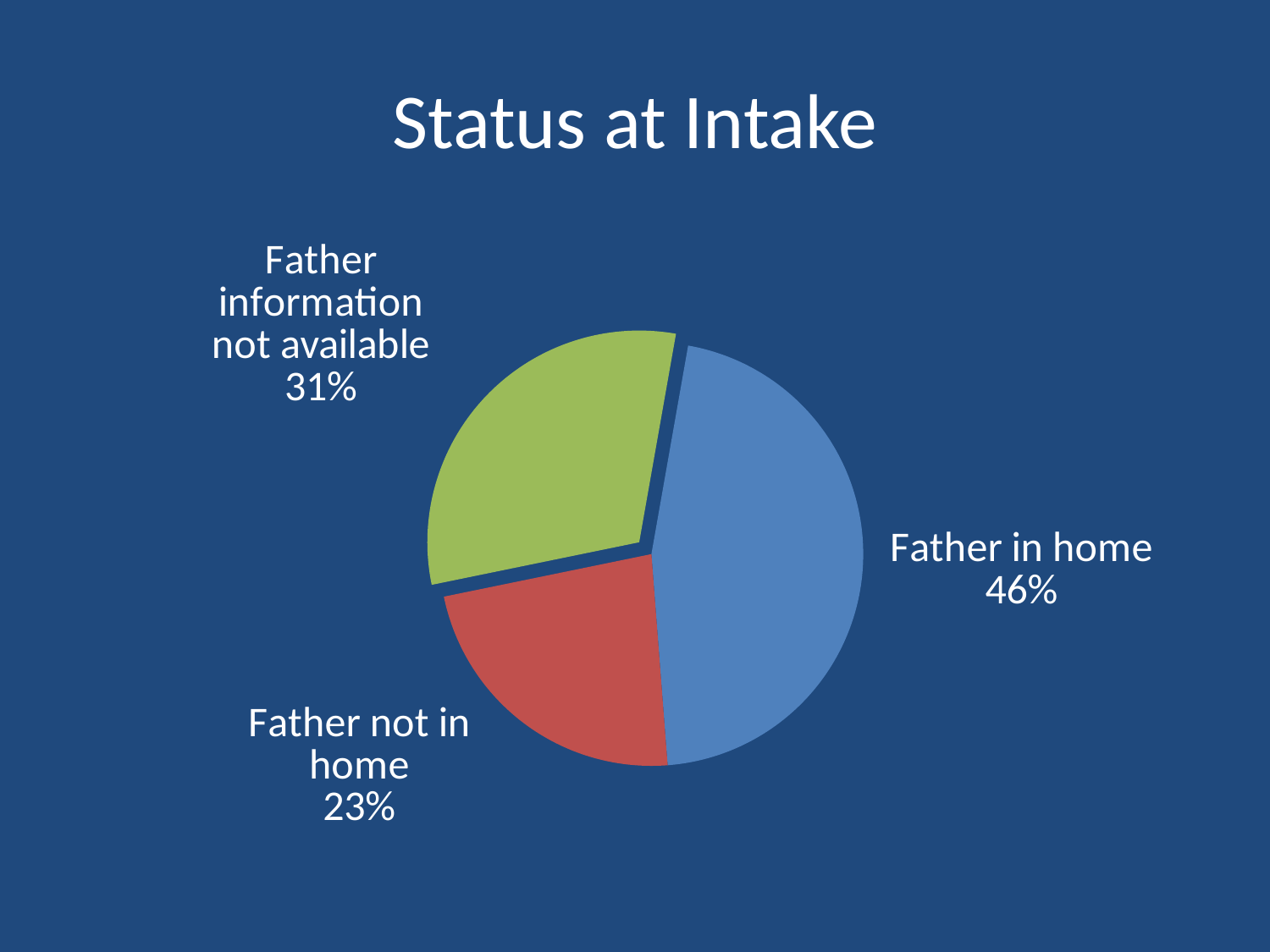
Which is larger: the share for 'Father information not available' or the share for 'Father not in home'? Father information not available What colour is the 'Father in home' slice? blue What share of the pie is 'Father in home'? 46% Which category has the smallest share of the pie? Father not in home Which category has the largest share of the pie? Father in home What share of the pie is 'Father not in home'? 23% What share of the pie is 'Father information not available'? 31% What is the title of the chart? Status at Intake How many slices does the pie chart have? 3 What is the difference in percentage points between 'Father information not available' and 'Father not in home'? 8 What kind of chart is shown on the slide? pie chart What is the difference in percentage points between 'Father in home' and 'Father not in home'? 23